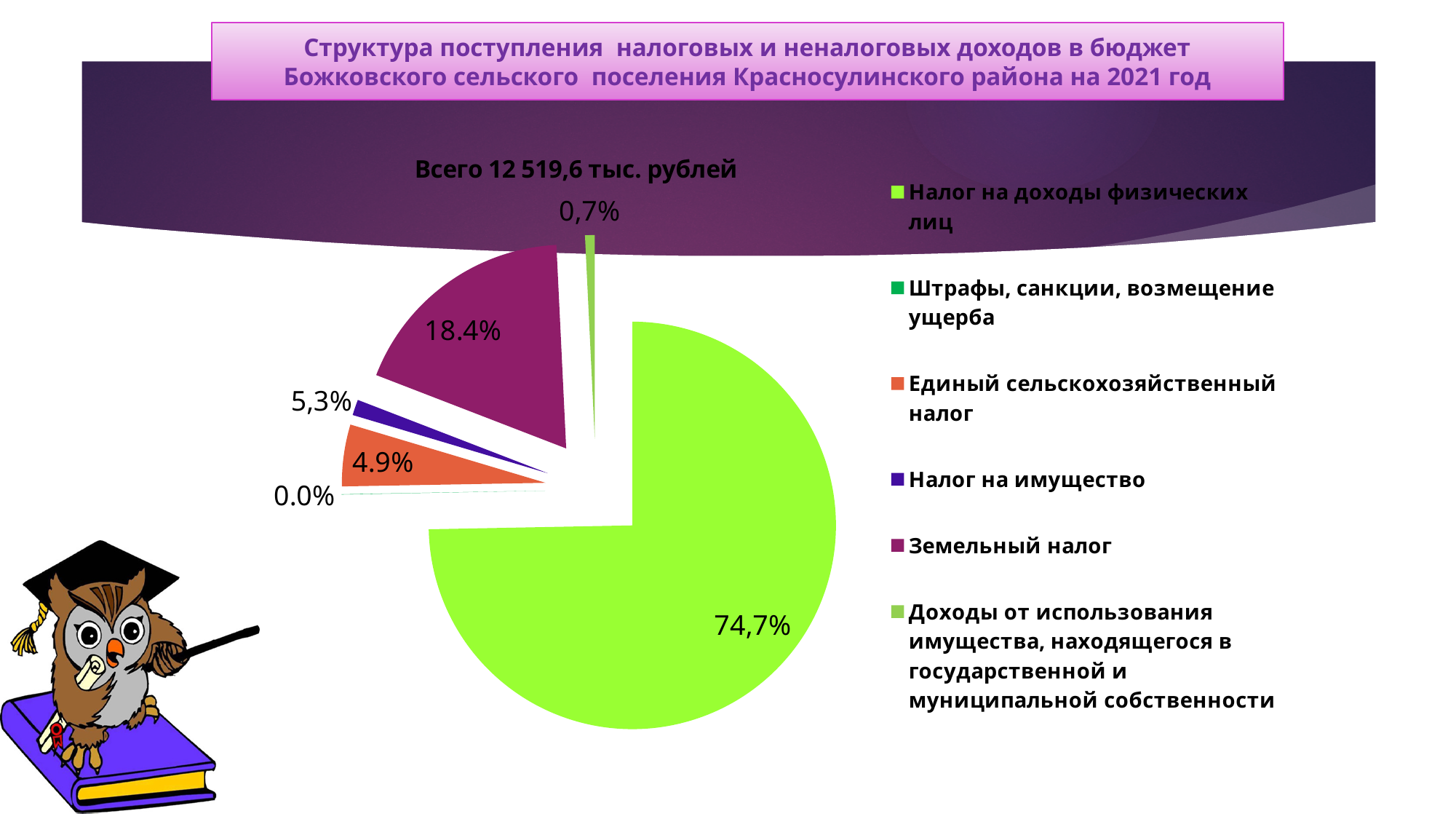
Which category has the largest slice of the pie? Налог на доходы физических лиц What total amount is stated in the chart title above the pie? Всего 12 519,6 тыс. рублей What share of the pie does "Земельный налог" have? 18.4% What share of the pie does "Единый сельскохозяйственный налог" have? 4.9% What share of the pie does "Налог на имущество" have? 5,3% Which category has the smallest slice of the pie? Штрафы, санкции, возмещение ущерба What share of the pie does "Доходы от использования имущества, находящегося в государственной и муниципальной собственности" have? 0,7% What share of the pie does "Налог на доходы физических лиц" have? 74,7% What share of the pie does "Штрафы, санкции, возмещение ущерба" have? 0.0% How many categories does the legend list? 6 Which is larger: the slice for "Земельный налог" or the slice for "Налог на имущество"? Земельный налог What kind of chart is shown on the slide? pie chart